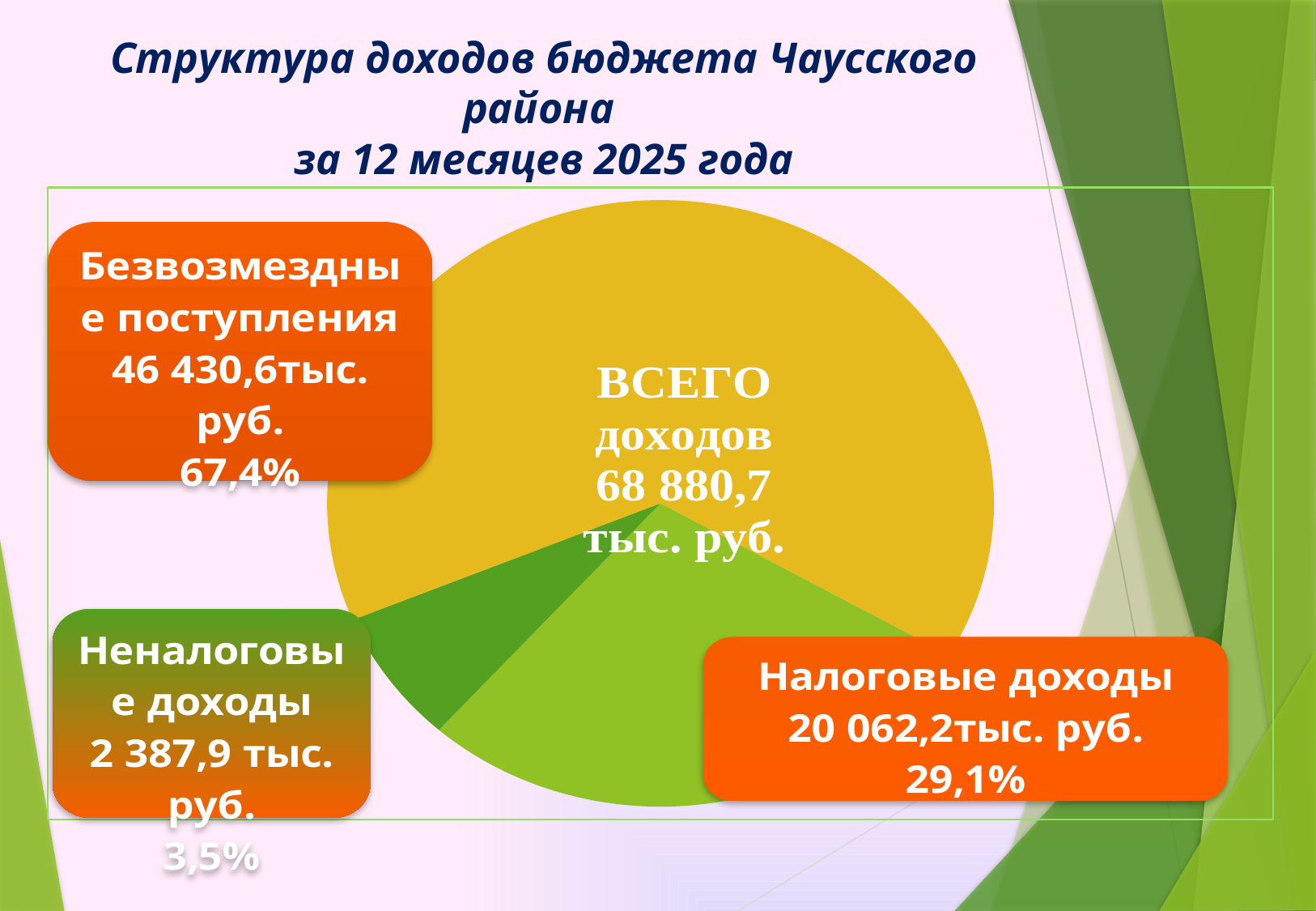
What share of the pie is Налоговые доходы? 29,1% What is the difference in percentage share between Безвозмездные поступления and Налоговые доходы? 38,3% Which category has the largest slice of the pie? Безвозмездные поступления Which category has the smallest slice of the pie? Неналоговые доходы What is the value for Безвозмездные поступления? 46 430,6 тыс. руб. What share of the pie is Неналоговые доходы? 3,5% How many slices does the pie chart have? 3 What is the total of all income shown in the centre of the pie chart? 68 880,7 тыс. руб. What is the value for Неналоговые доходы? 2 387,9 тыс. руб. What is the value for Налоговые доходы? 20 062,2 тыс. руб. What share of the pie is Безвозмездные поступления? 67,4% What kind of chart is shown on the slide? pie chart